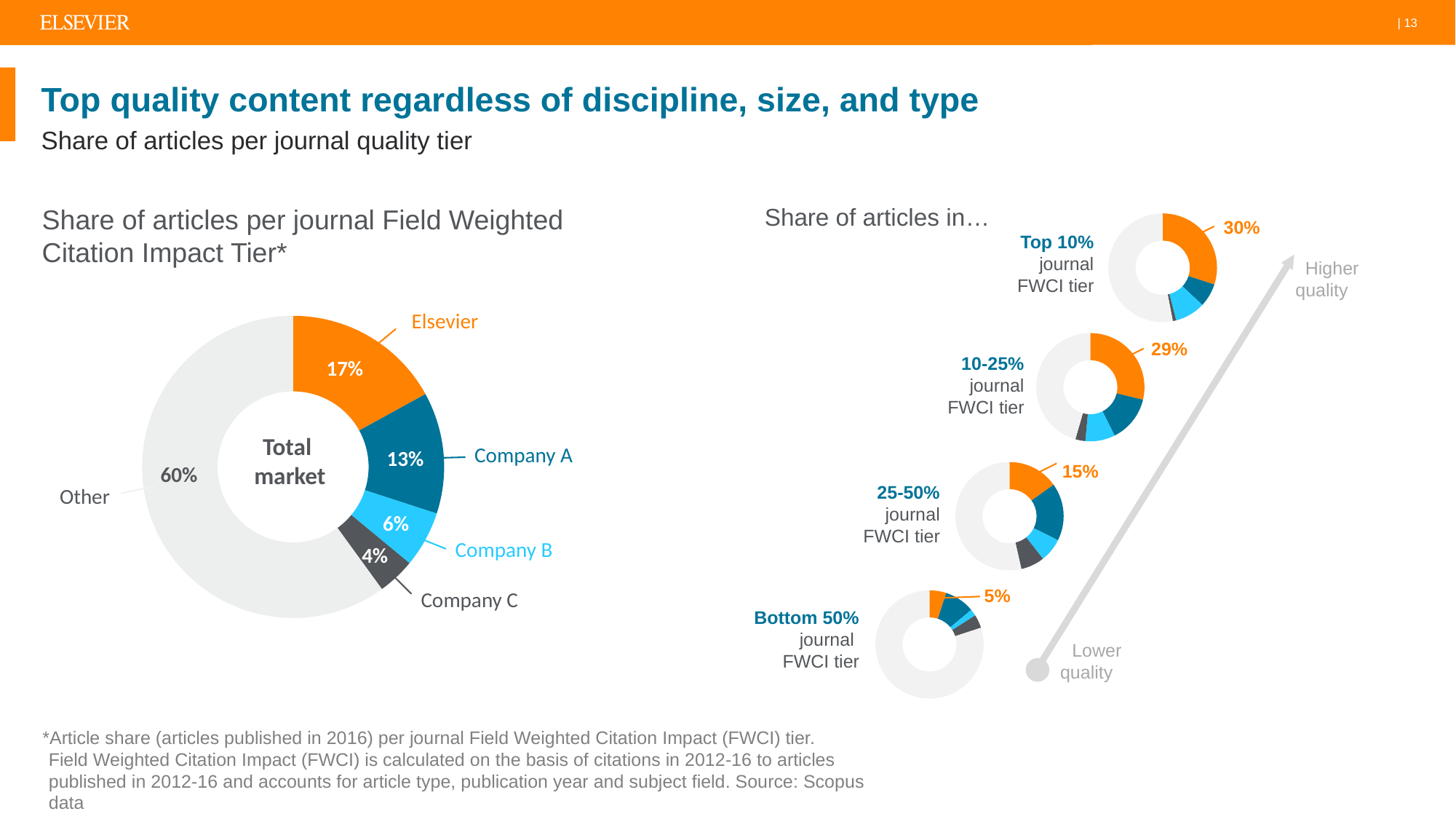
In the Total market donut chart, what share of articles does Elsevier have? 17% In the Total market donut chart, which named company has the smallest share of articles? Company C In the Total market donut chart, what share of articles does Company A have? 13% In the Total market donut chart, what is the difference between Elsevier's share and Company A's share? 4% In the small donut charts on the right, what is Elsevier's share of articles in the Top 10% journal FWCI tier? 30% In the Total market donut chart, which is larger: Company B's share or Company C's share? Company B In the Total market donut chart, which named company has the largest share of articles? Elsevier In the small donut charts on the right, what is Elsevier's share of articles in the Bottom 50% journal FWCI tier? 5% In the Total market donut chart, what share of articles does Company C have? 4% In the small donut charts on the right, what is the difference between Elsevier's share in the 10-25% tier and the 25-50% tier? 14% What kind of chart is the Total market chart on the left? Donut (pie) chart How many segments does the Total market donut chart have? 5